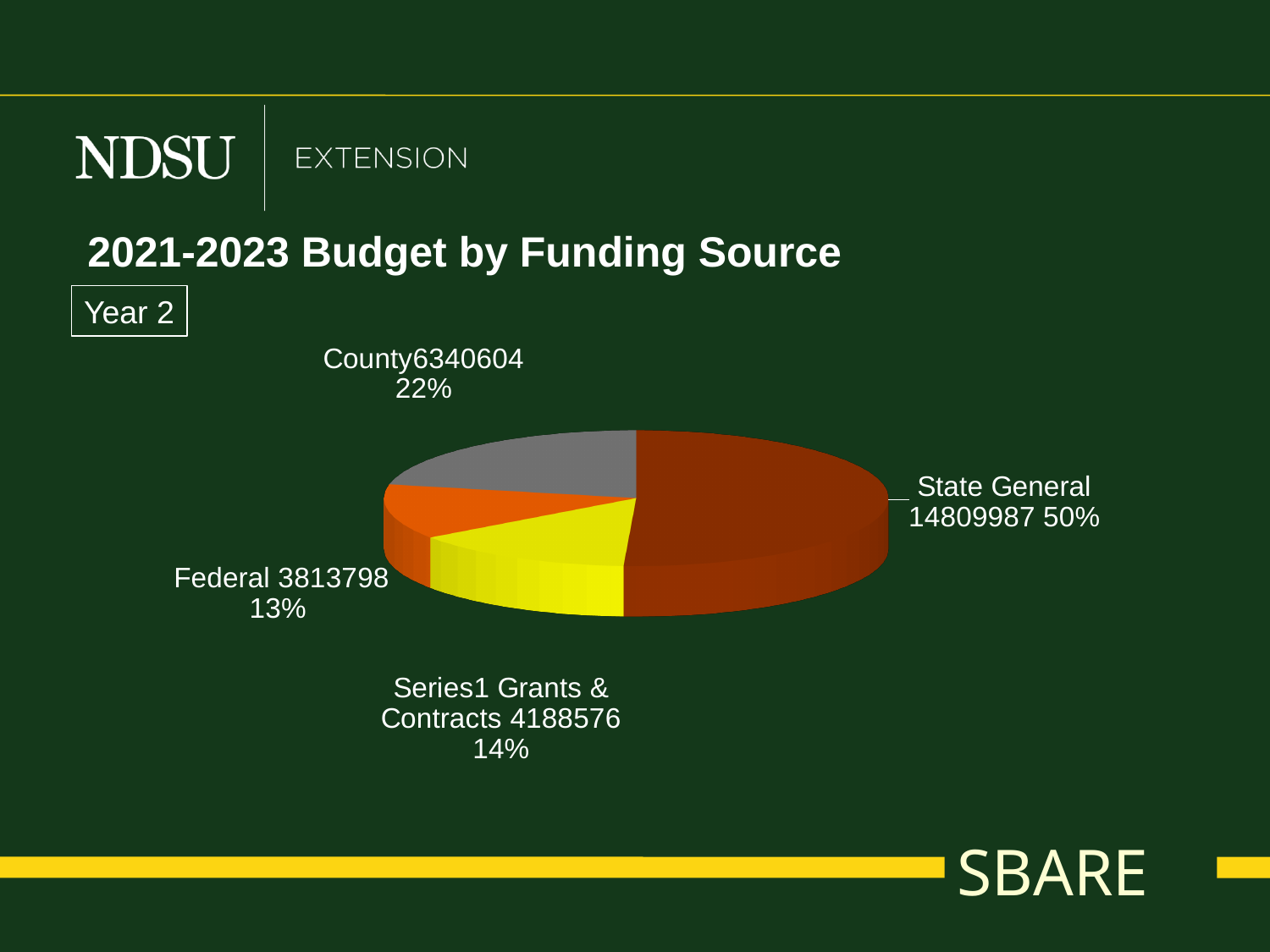
What is the difference between the State General value and the County value? 8469383 What share of the pie does County represent? 22% Which funding source has the largest share of the pie? State General What is the value for State General? 14809987 What is the value for County? 6340604 What kind of chart is shown on the slide? Pie chart What is the value for Grants & Contracts? 4188576 Which is larger, the value for Grants & Contracts or the value for Federal? Grants & Contracts What share of the pie does Grants & Contracts represent? 14% How many funding sources are shown in the pie chart? 4 What is the value for Federal? 3813798 Which funding source has the smallest share of the pie? Federal